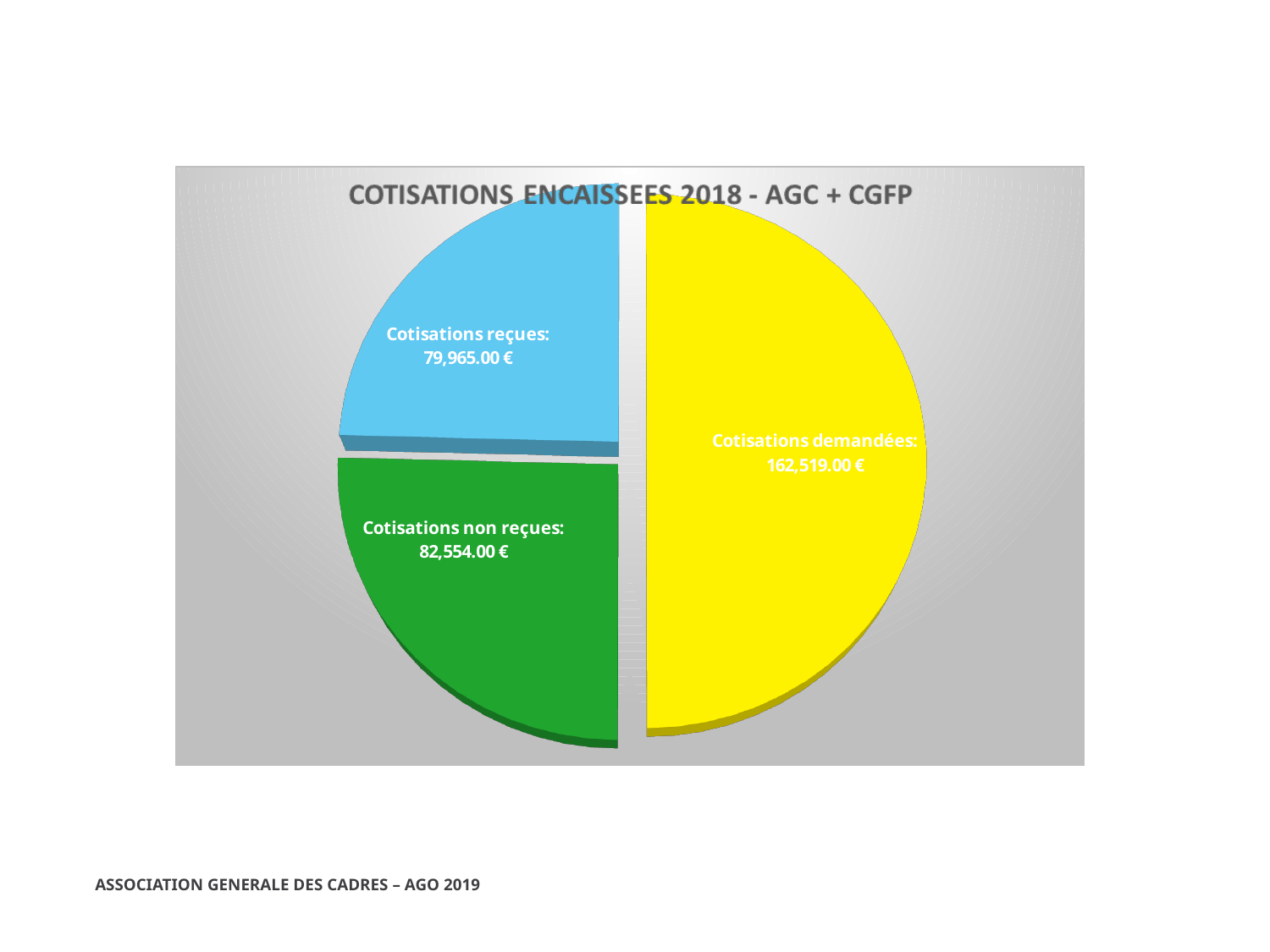
What is the value of the Cotisations non reçues slice? 82,554.00 € What is the title of the chart? COTISATIONS ENCAISSEES 2018 - AGC + CGFP What is the value of the Cotisations reçues slice? 79,965.00 € What is the difference between Cotisations demandées and Cotisations non reçues? 79,965.00 € Which is larger, Cotisations non reçues or Cotisations reçues? Cotisations non reçues How many slices does the pie chart have? 3 What share of the pie does the Cotisations demandées slice represent? 50% What is the value of the Cotisations demandées slice? 162,519.00 € What kind of chart is shown on the slide? Pie chart What is the difference between Cotisations non reçues and Cotisations reçues? 2,589.00 € Which slice has the largest value? Cotisations demandées Which slice has the smallest value? Cotisations reçues